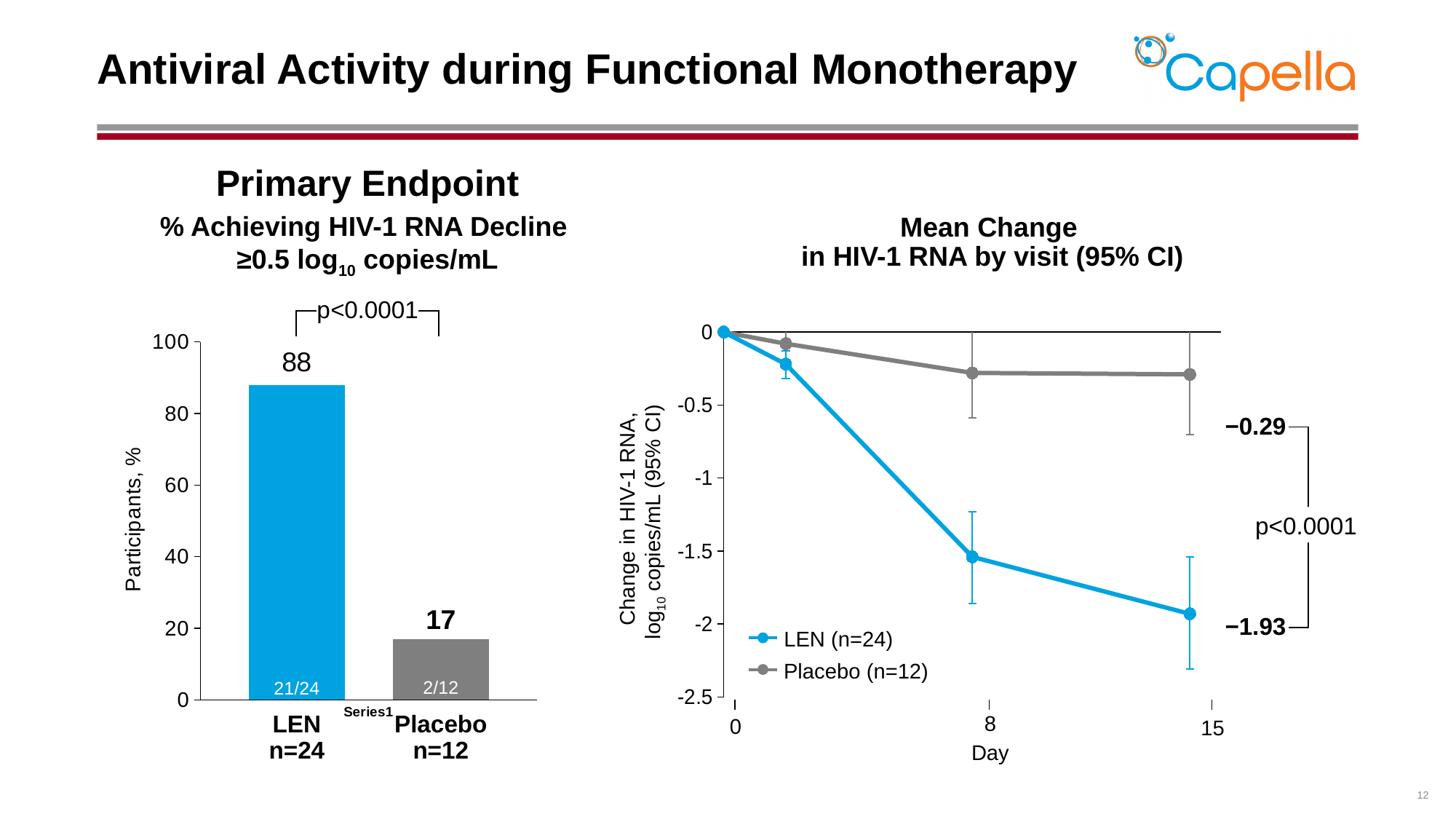
In the line chart on the right, what is the mean change in HIV-1 RNA for the Placebo group at Day 15? −0.29 In the bar chart on the left, how many bars are plotted? 2 In the line chart on the right, does the LEN line rise or fall from Day 0 to Day 15? fall In the line chart on the right, is the LEN value at Day 8 greater or less than -1? less In the bar chart on the left, which group has the higher percentage of participants achieving the endpoint? LEN What kind of chart is the 'Mean Change in HIV-1 RNA by visit (95% CI)' chart on the right? line chart In the line chart on the right, what is the mean change in HIV-1 RNA for the LEN group at Day 15? −1.93 In the line chart on the right, how many series does the legend list? 2 In the bar chart on the left, what percentage of participants in the LEN group achieved an HIV-1 RNA decline of ≥0.5 log10 copies/mL? 88 In the bar chart on the left, how many participants out of the total in the LEN group achieved the endpoint, as printed on the bar? 21/24 In the bar chart on the left, what percentage of participants in the Placebo group achieved an HIV-1 RNA decline of ≥0.5 log10 copies/mL? 17 In the bar chart on the left, what is the difference in percentage points between the LEN and Placebo bars? 71